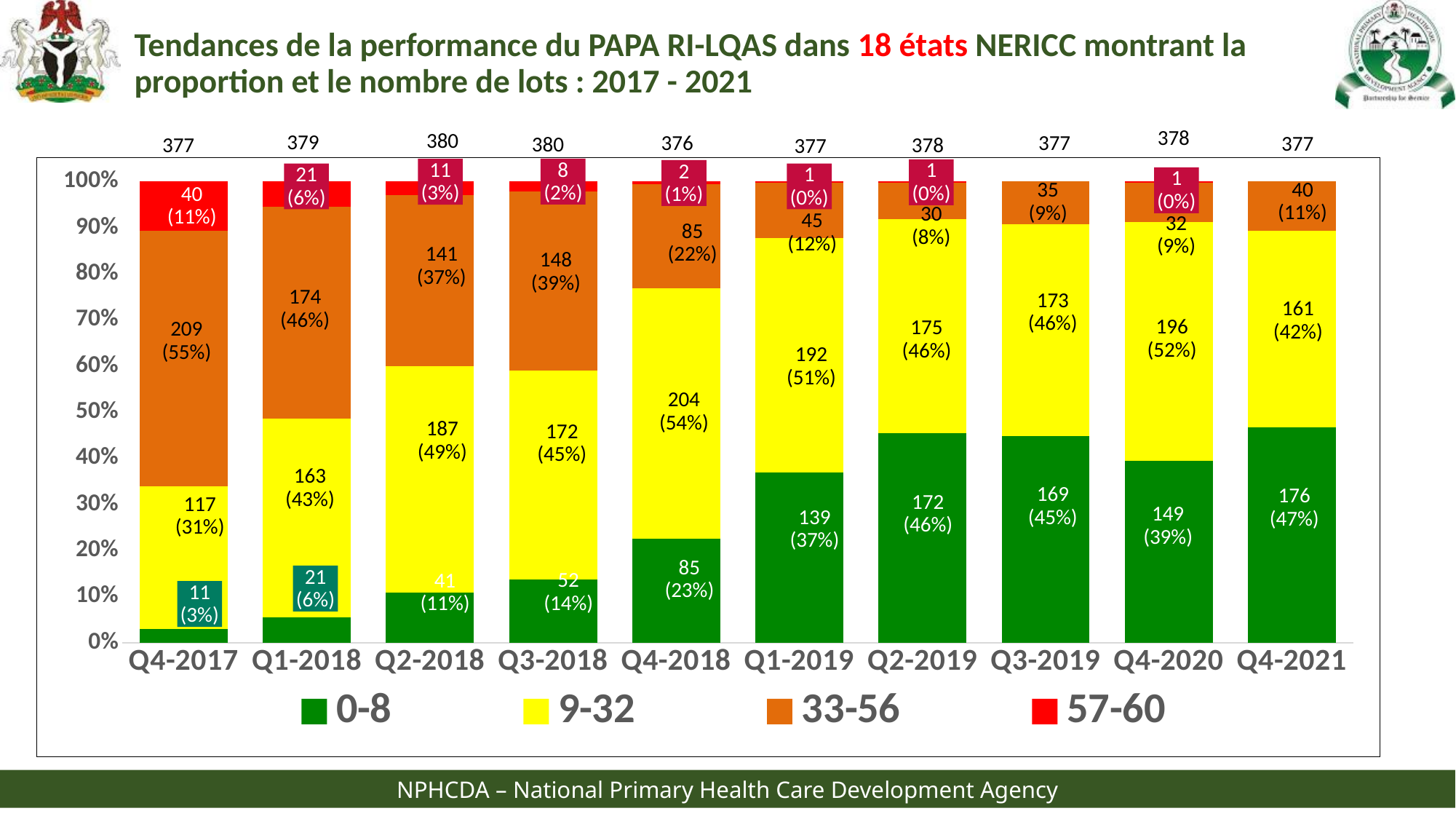
What is the number of lots in the 9-32 category for Q4-2018? 204 What kind of chart is shown on the slide? Stacked bar chart Which quarter has the lowest number of lots in the 0-8 category? Q4-2017 Which is larger in Q2-2019: the number of 0-8 lots or the number of 9-32 lots? 9-32 lots (175) How many series does the legend list? 4 What is the total number of lots shown above the bar for Q2-2018? 380 What percentage of lots fell in the 33-56 category in Q4-2017? 55% Does the share of lots in the 0-8 category generally rise or fall from Q4-2017 to Q4-2021? Rise What is the difference between the number of 33-56 lots in Q4-2017 and in Q1-2018? 35 What is the number of lots in the 0-8 category for Q4-2021? 176 Which quarter has the highest number of lots in the 0-8 category? Q4-2021 How many quarters (categories) are shown along the x axis? 10